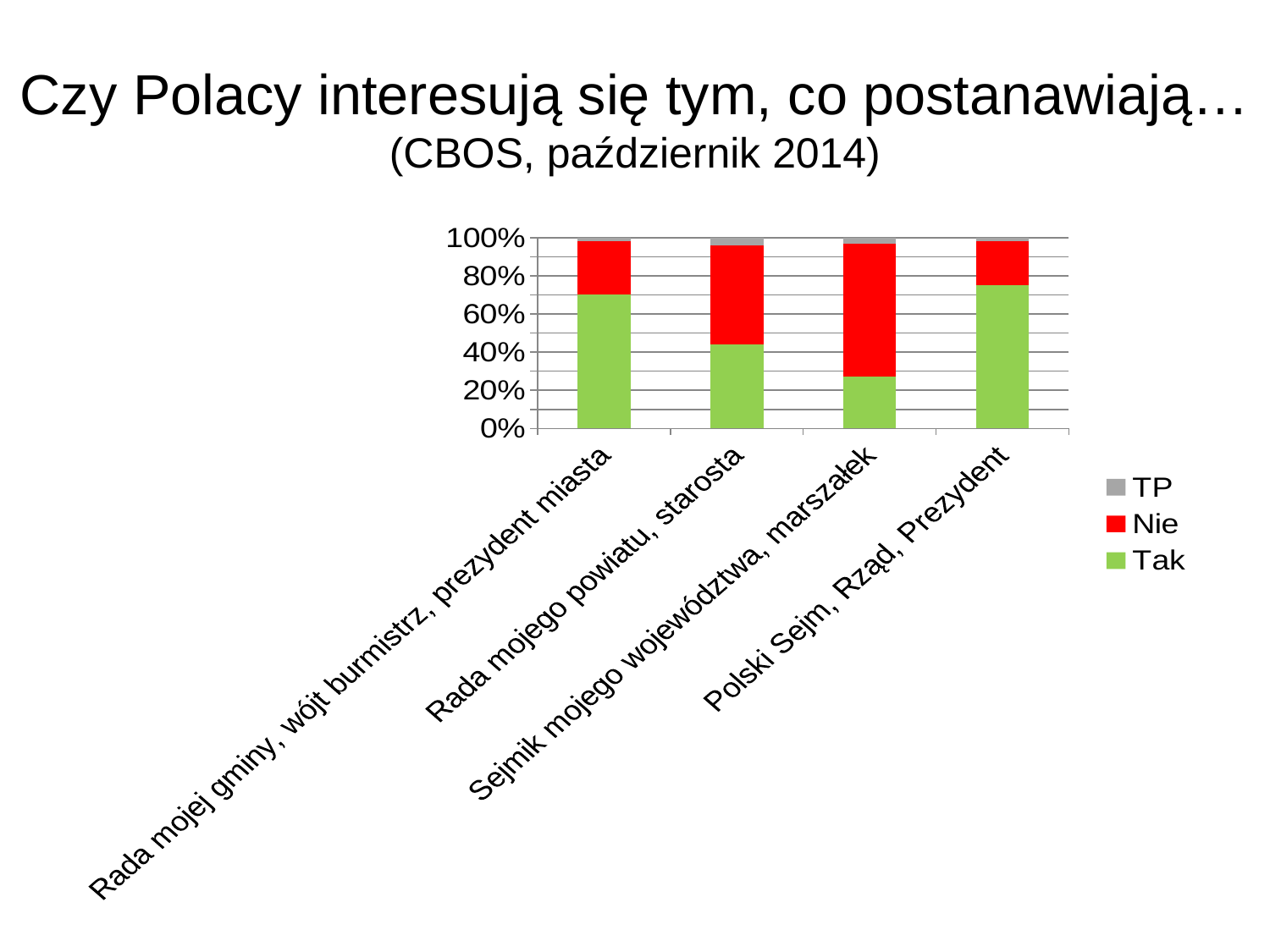
Which category has the highest 'Nie' value? Sejmik mojego województwa, marszałek Is the 'Tak' value for 'Rada mojej gminy, wójt burmistrz, prezydent miasta' greater or less than 60%? greater Is the 'Tak' value for 'Rada mojego powiatu, starosta' greater or less than 60%? less Is the 'Tak' value for 'Sejmik mojego województwa, marszałek' greater or less than 40%? less What kind of chart is shown on the slide? stacked bar chart Which series are listed in the chart's legend? TP, Nie, Tak Which is larger: the 'Tak' value for 'Rada mojej gminy, wójt burmistrz, prezydent miasta' or for 'Sejmik mojego województwa, marszałek'? Rada mojej gminy, wójt burmistrz, prezydent miasta How many series does the chart's legend list? 3 How many categories are shown on the x axis of the chart? 4 Which category has the lowest 'Tak' value? Sejmik mojego województwa, marszałek What colour represents the 'Tak' series in the chart? green